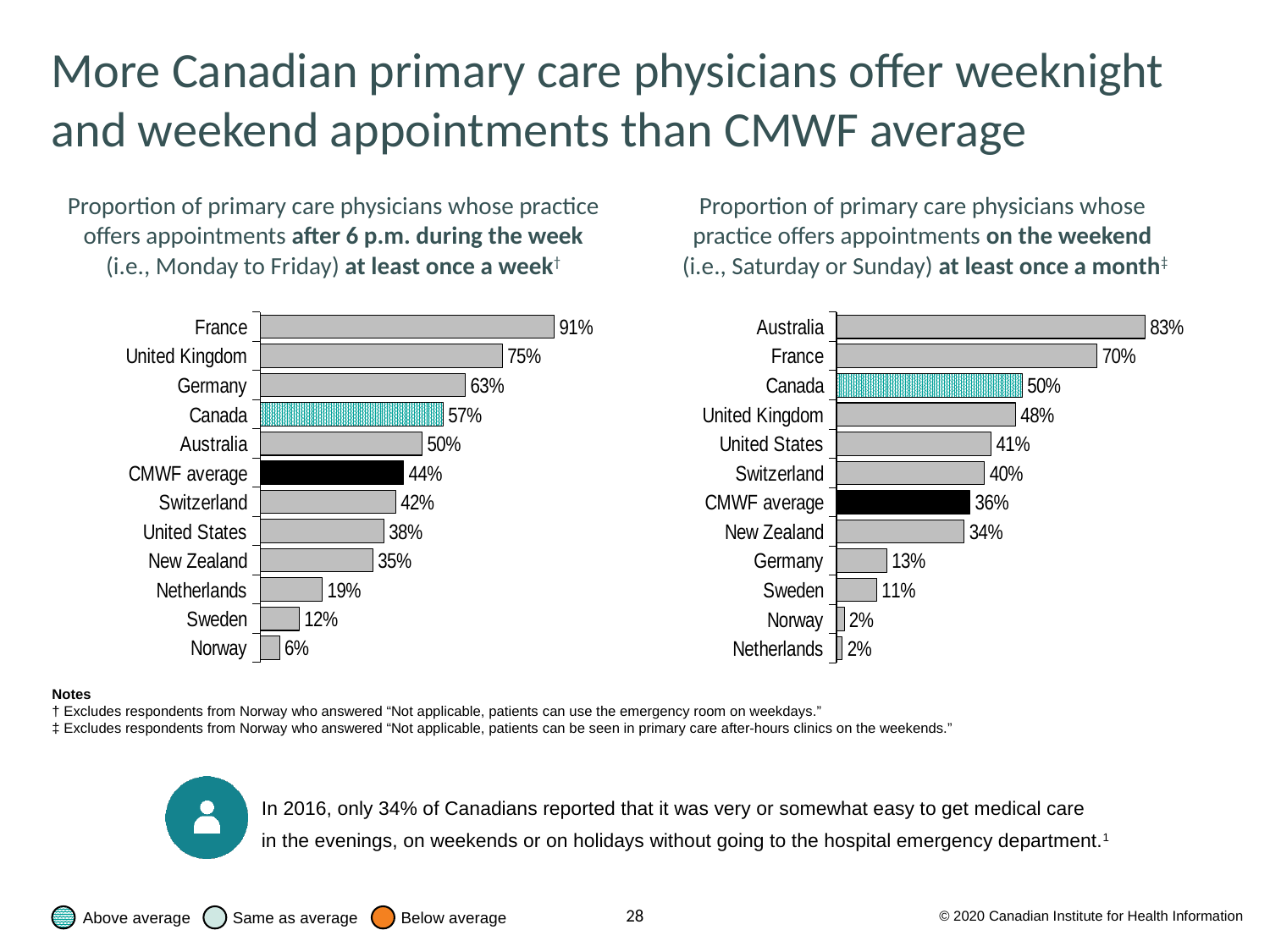
In the right chart (appointments on the weekend), what is the value for the United Kingdom? 48% In the right chart (appointments on the weekend), which country has the highest value? Australia In the right chart (appointments on the weekend), which is larger, the value for Germany or the value for New Zealand? New Zealand What kind of chart is the right chart (appointments on the weekend)? Bar chart In the left chart (appointments after 6 p.m. during the week), what is the difference between Canada and the CMWF average? 13% How many countries or categories are shown in the left chart (appointments after 6 p.m. during the week)? 12 In the left chart (appointments after 6 p.m. during the week), what is the value for Canada? 57% In the left chart (appointments after 6 p.m. during the week), what is the value for the Netherlands? 19% In the left chart (appointments after 6 p.m. during the week), which country has the lowest value? Norway In the right chart (appointments on the weekend), what is the difference between Australia and France? 13% In the right chart (appointments on the weekend), what is the value for the CMWF average? 36% In the left chart (appointments after 6 p.m. during the week), which country has the highest value? France